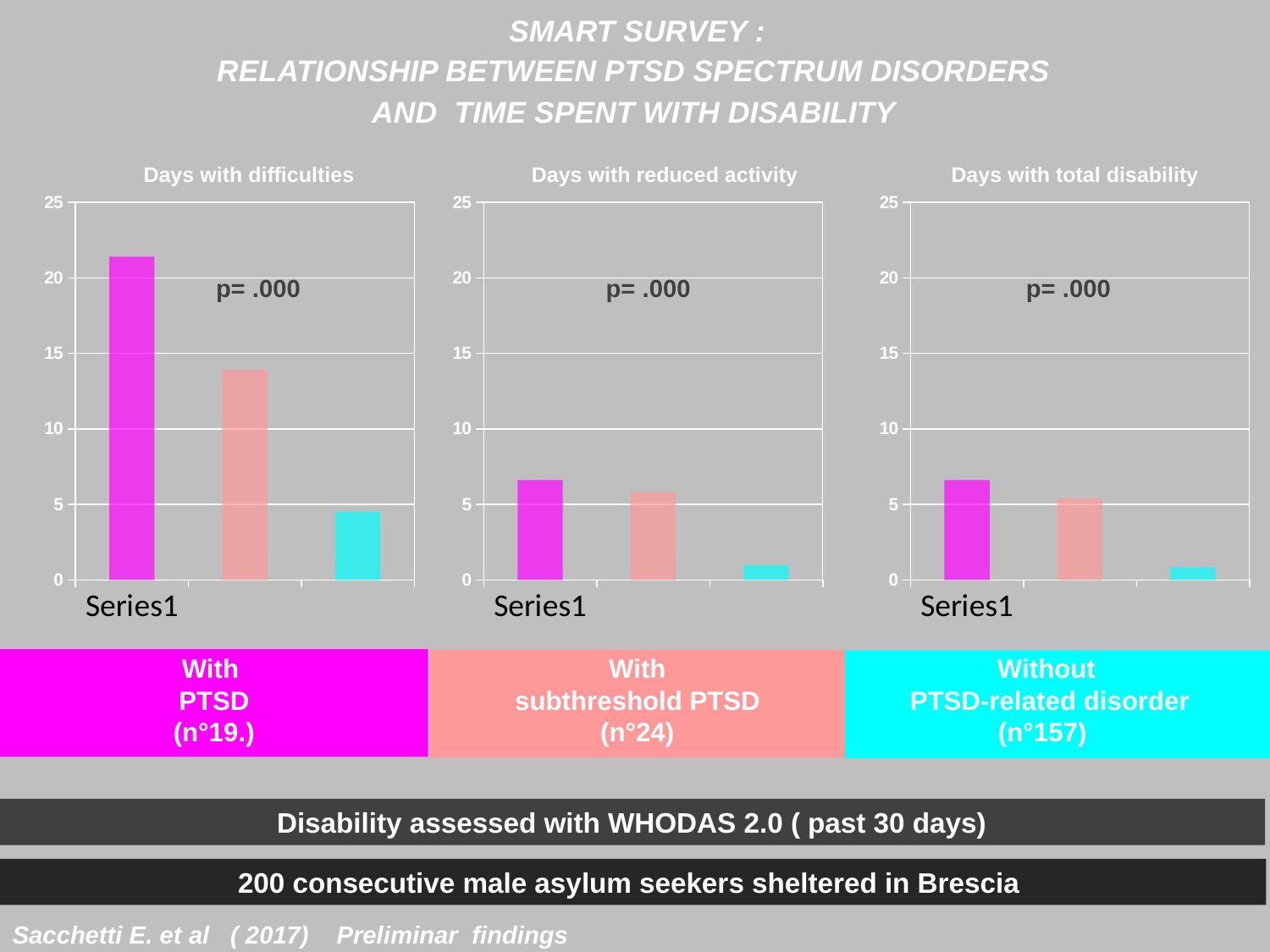
In the 'Days with reduced activity' chart, which group has the lowest value? Without PTSD-related disorder What p-value is printed on the 'Days with total disability' chart? p= .000 In the 'Days with difficulties' chart, what kind of chart is shown? bar chart In the 'Days with difficulties' chart, which group has the lowest value? Without PTSD-related disorder In the 'Days with difficulties' chart, which is larger: the value for With PTSD or the value for With subthreshold PTSD? With PTSD In the 'Days with difficulties' chart, is the value for the Without PTSD-related disorder group greater or less than 5? less In the 'Days with total disability' chart, which group has the highest value? With PTSD In the 'Days with difficulties' chart, is the value for the With PTSD group greater or less than 20? greater In the 'Days with difficulties' chart, which group has the highest value? With PTSD In the 'Days with difficulties' chart, how many bars are plotted? 3 In the 'Days with reduced activity' chart, is the value for the With PTSD group greater or less than 10? less